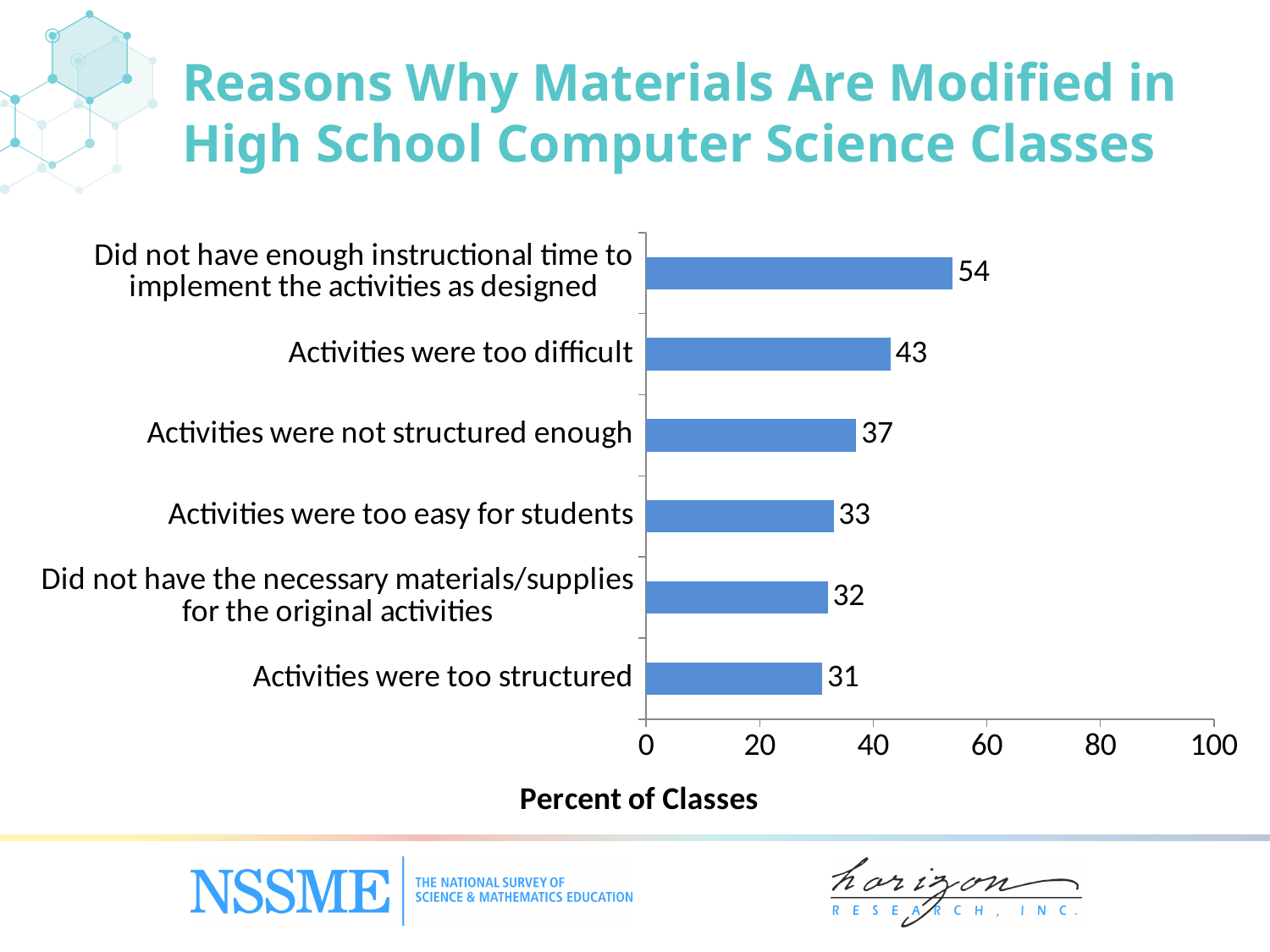
Which reason has the lowest percent of classes? Activities were too structured Is the value for "Did not have enough instructional time to implement the activities as designed" greater or less than 40? greater Which is larger: the value for "Activities were not structured enough" or the value for "Did not have the necessary materials/supplies for the original activities"? Activities were not structured enough What is the difference between the values for "Activities were too difficult" and "Activities were too easy for students"? 10 Which reason has the highest percent of classes? Did not have enough instructional time to implement the activities as designed How many reasons are shown in the chart? 6 What is the value for "Activities were too difficult"? 43 What percent of classes modified materials because they did not have enough instructional time to implement the activities as designed? 54 What is the label of the horizontal axis? Percent of Classes What kind of chart is shown on the slide? Bar chart What is the value for "Activities were too structured"? 31 What is the value for "Activities were not structured enough"? 37